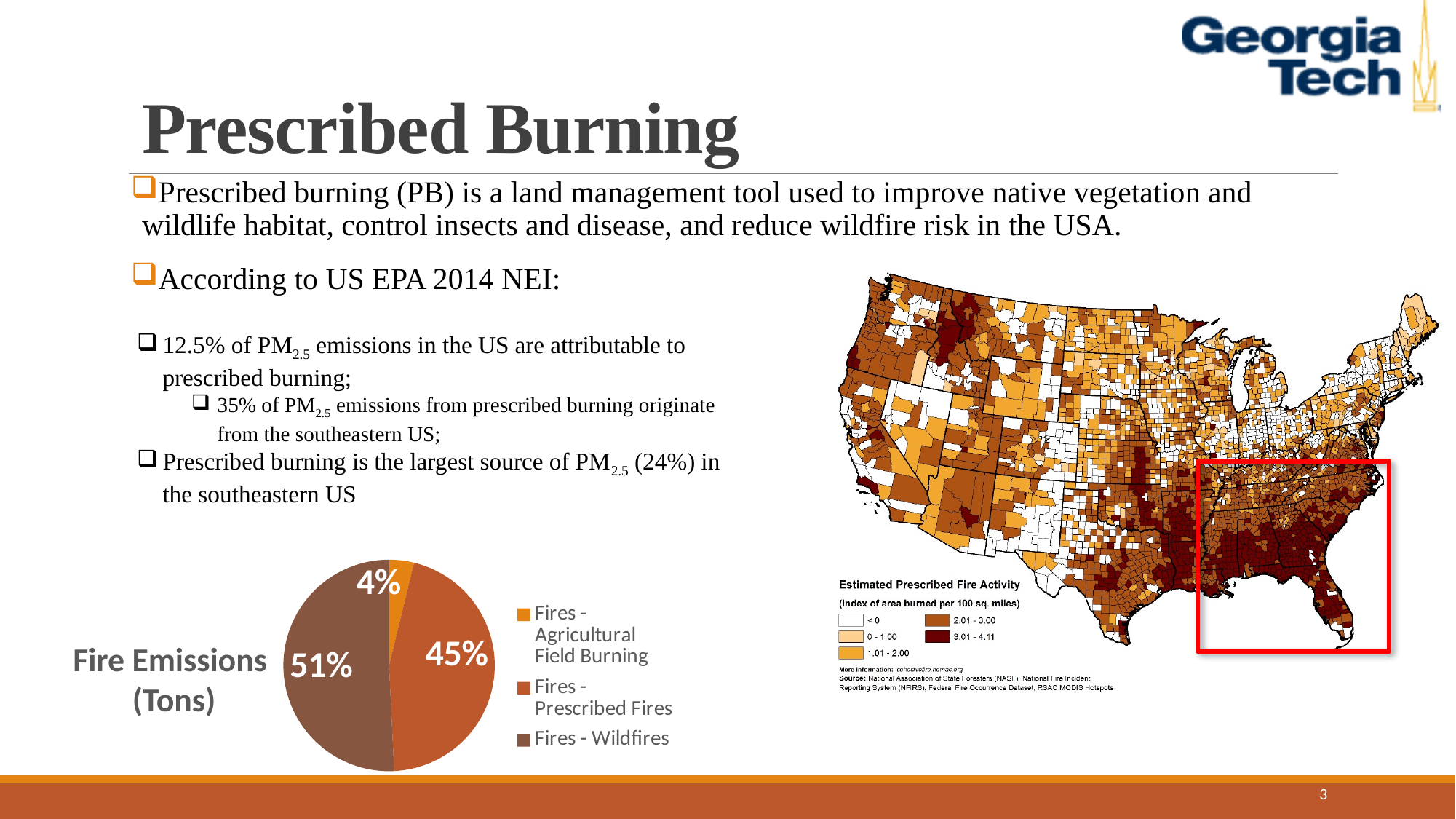
In the Fire Emissions (Tons) pie chart, what share is attributed to Fires - Prescribed Fires? 45% How many slices does the Fire Emissions (Tons) pie chart have? 3 Which category has the smallest slice in the Fire Emissions (Tons) pie chart? Fires - Agricultural Field Burning In the Fire Emissions (Tons) pie chart, what is the difference in percentage points between Fires - Prescribed Fires and Fires - Agricultural Field Burning? 41 percentage points How many entries does the legend of the Fire Emissions (Tons) pie chart list? 3 What kind of chart is the Fire Emissions (Tons) chart? Pie chart Which category has the largest slice in the Fire Emissions (Tons) pie chart? Fires - Wildfires In the Fire Emissions (Tons) pie chart, which is larger: Fires - Prescribed Fires or Fires - Agricultural Field Burning? Fires - Prescribed Fires In the Fire Emissions (Tons) pie chart, what is the difference in percentage points between Fires - Wildfires and Fires - Prescribed Fires? 6 percentage points What is the title of the pie chart on the slide? Fire Emissions (Tons) In the Fire Emissions (Tons) pie chart, what share is attributed to Fires - Agricultural Field Burning? 4% In the Fire Emissions (Tons) pie chart, what share is attributed to Fires - Wildfires? 51%